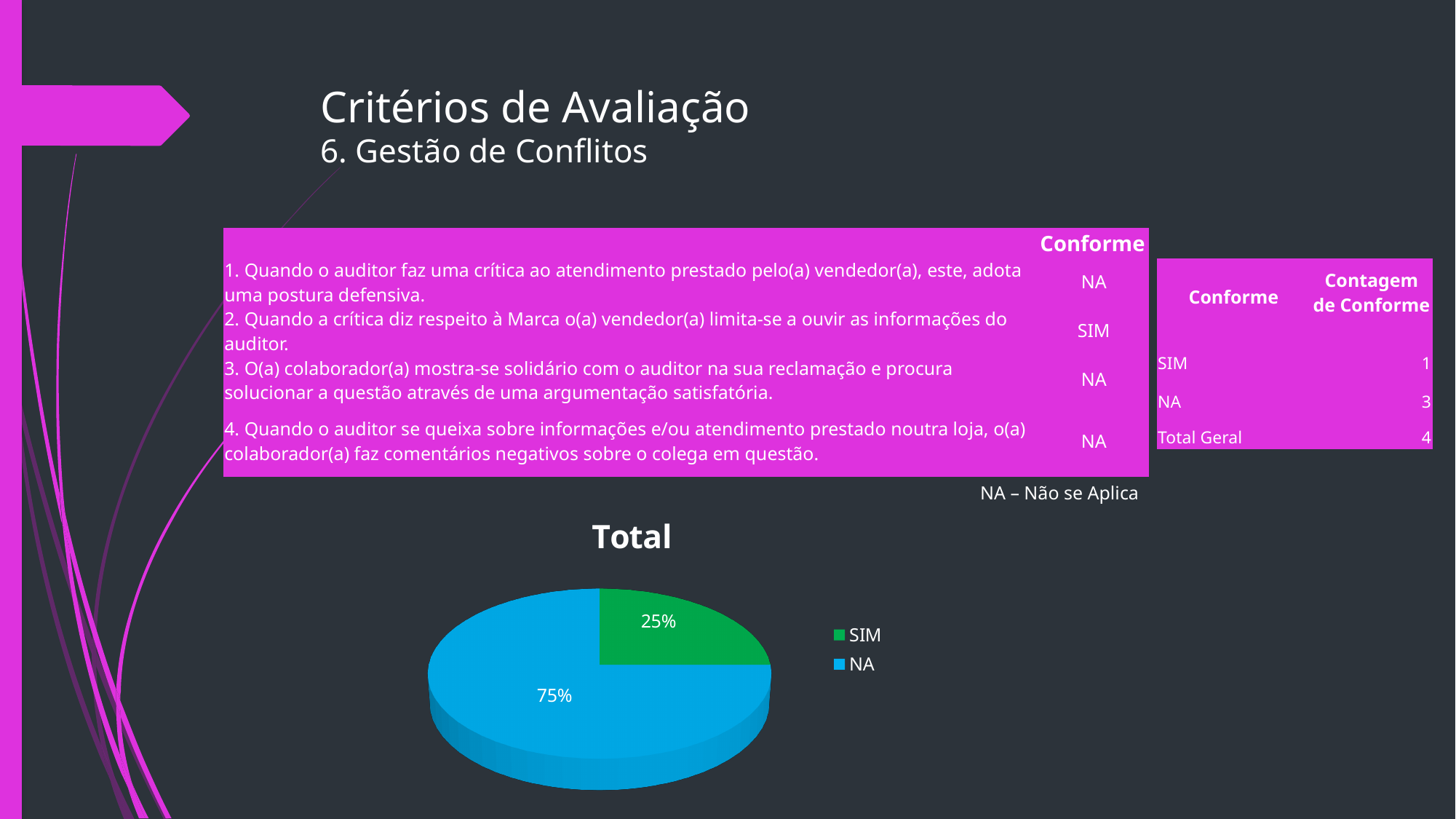
What kind of chart is shown on the slide? pie chart What share of the pie does SIM represent? 25% How many slices does the pie chart have? 2 Which slice of the pie chart is the largest? NA How many entries does the legend of the pie chart list? 2 What colour is the NA slice in the pie chart? blue What is the title of the pie chart? Total What is the difference in percentage points between the NA slice and the SIM slice? 50% What share of the pie does NA represent? 75% Is the share for NA greater or less than 50%? greater Which slice of the pie chart is the smallest? SIM Which is larger in the pie chart, SIM or NA? NA